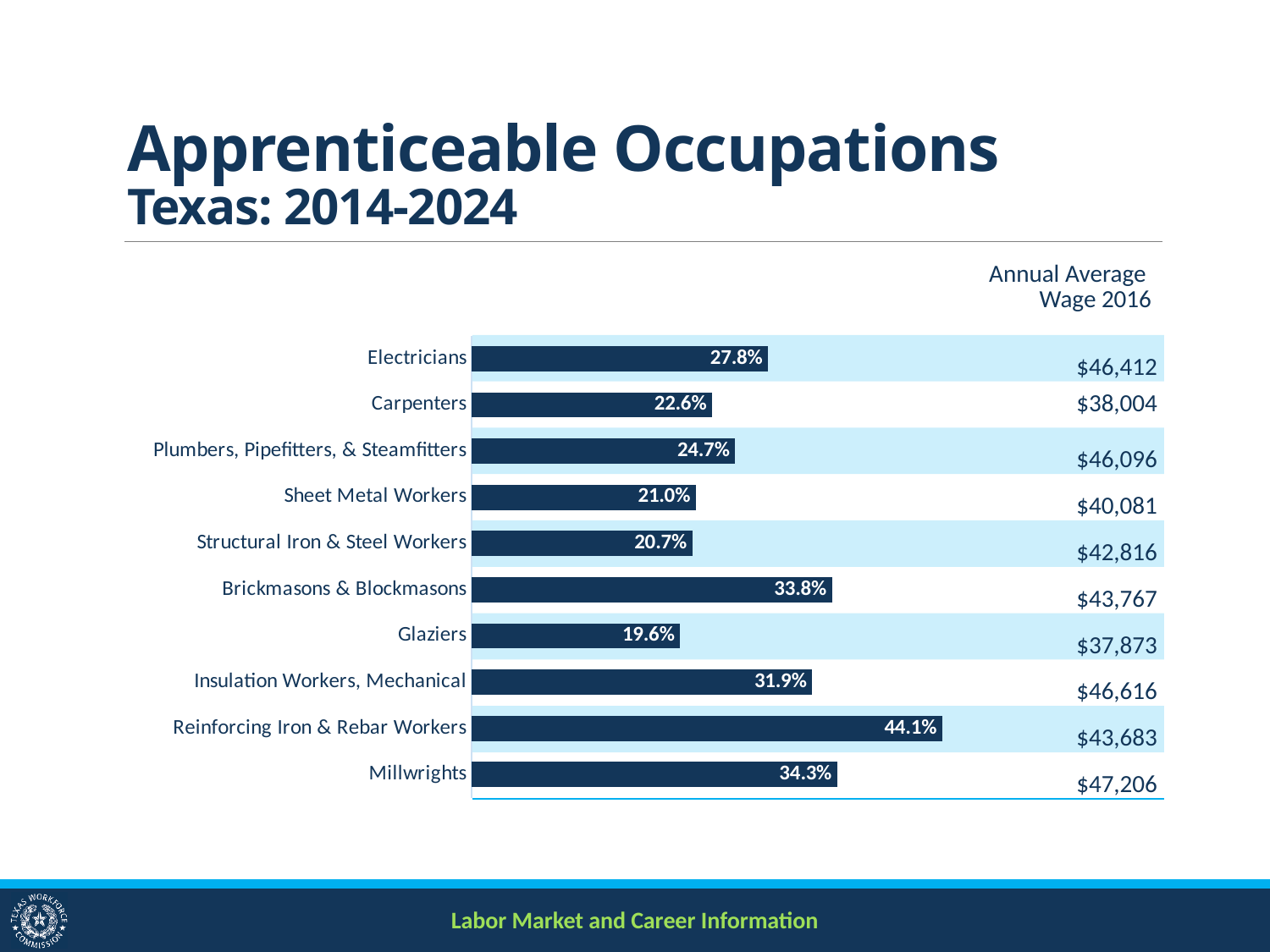
Which occupation has the lowest percentage value in the chart? Glaziers What is the Annual Average Wage 2016 listed for Millwrights? $47,206 What is the difference in percentage points between Reinforcing Iron & Rebar Workers and Millwrights? 9.8 percentage points What is the Annual Average Wage 2016 listed for Carpenters? $38,004 What is the percentage value shown for Electricians? 27.8% What kind of chart is shown on the slide? Bar chart Which has the larger percentage value, Brickmasons & Blockmasons or Insulation Workers, Mechanical? Brickmasons & Blockmasons What is the percentage value shown for Glaziers? 19.6% Which occupation has the highest percentage value in the chart? Reinforcing Iron & Rebar Workers How many occupations are shown in the chart? 10 What is the title of the slide? Apprenticeable Occupations Texas: 2014-2024 Which occupation has the lowest Annual Average Wage 2016 shown? Glaziers